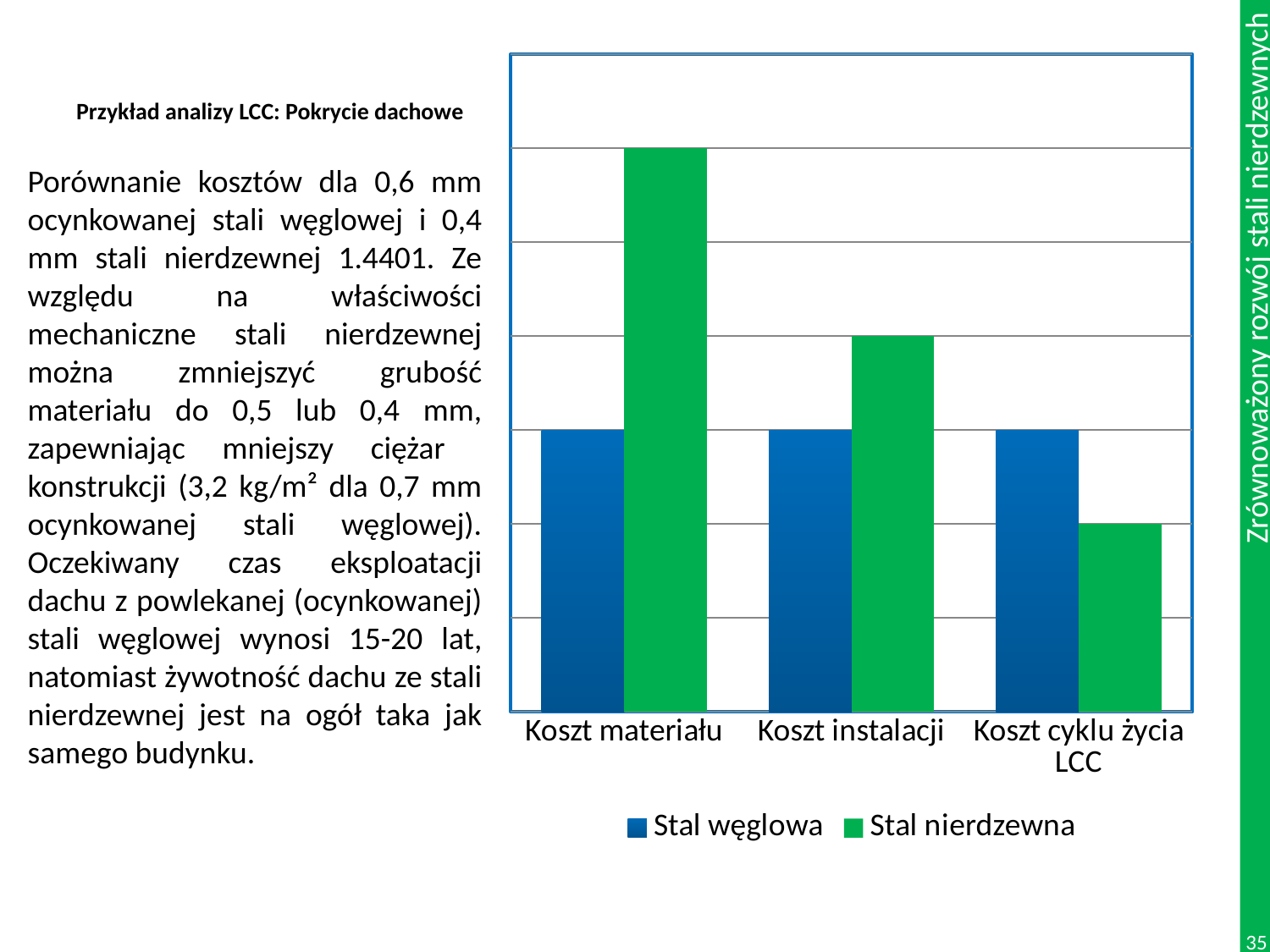
For Koszt cyklu życia LCC, which series has the larger value, Stal węglowa or Stal nierdzewna? Stal węglowa Which series are listed in the chart's legend? Stal węglowa, Stal nierdzewna Do the Stal nierdzewna values rise or fall from Koszt materiału to Koszt cyklu życia LCC? fall Is the Stal nierdzewna bar for Koszt materiału larger or smaller than the Stal nierdzewna bar for Koszt instalacji? larger How many series does the chart's legend list? 2 Which colour represents Stal nierdzewna in the chart? green How many categories are shown on the x axis of the chart? 3 What kind of chart is shown on the slide? bar chart For which category is the Stal nierdzewna bar the lowest? Koszt cyklu życia LCC For Koszt materiału, which series has the larger value, Stal węglowa or Stal nierdzewna? Stal nierdzewna For which category is the Stal nierdzewna bar the highest? Koszt materiału